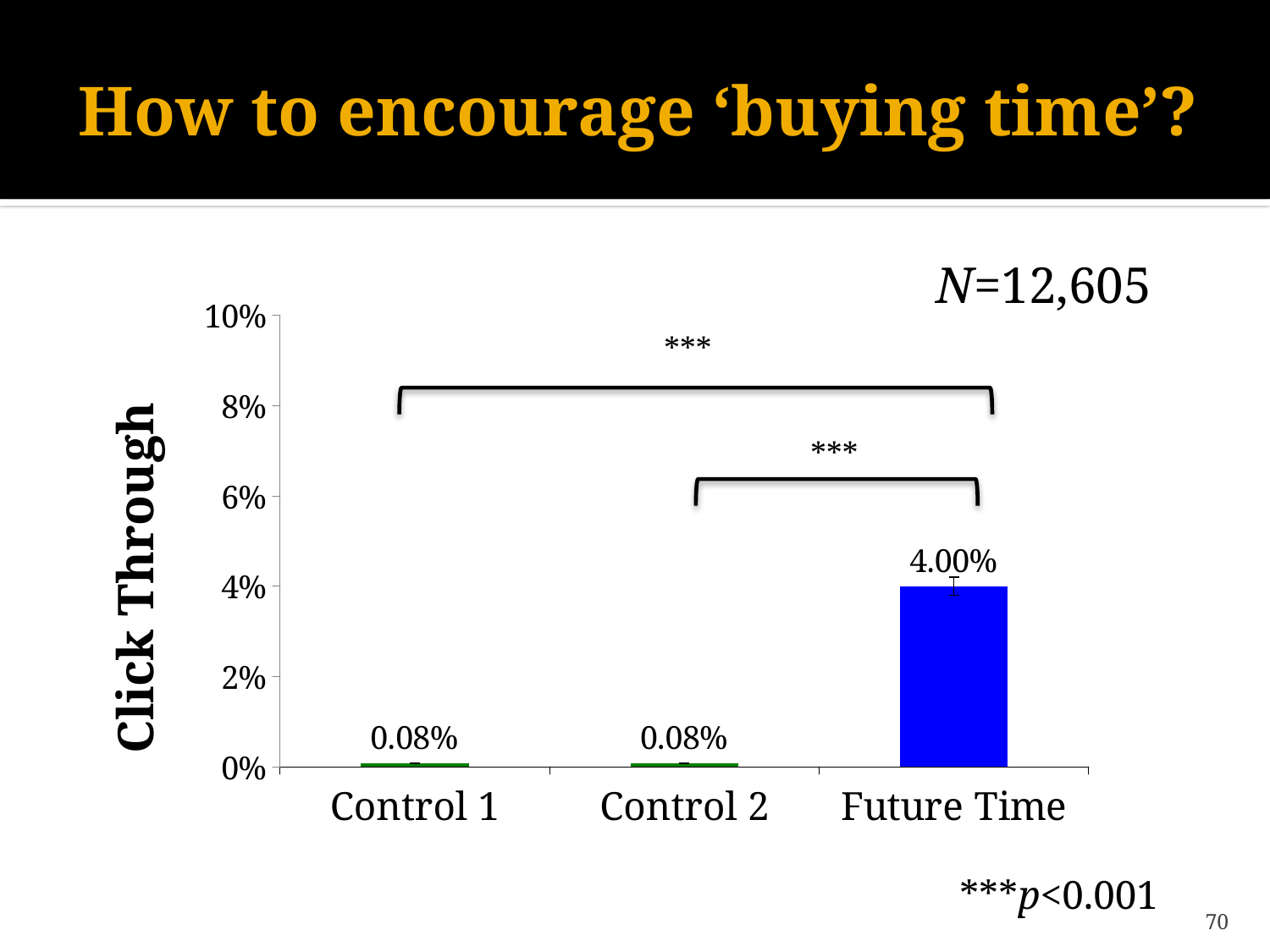
What is the click-through value for Control 1? 0.08% What is the click-through value for Control 2? 0.08% Is the click-through value for Future Time greater or less than 2%? greater What is the click-through value for Future Time? 4.00% How many categories are shown on the x axis? 3 Is the click-through value for Control 1 greater or less than 2%? less What is the difference in click-through between Future Time and Control 1? 3.92% Which is larger, the click-through for Future Time or for Control 2? Future Time What kind of chart is shown on the slide? bar chart What sample size (N) is stated on the slide? 12,605 What is the label of the y axis? Click Through Which category has the highest click-through rate? Future Time